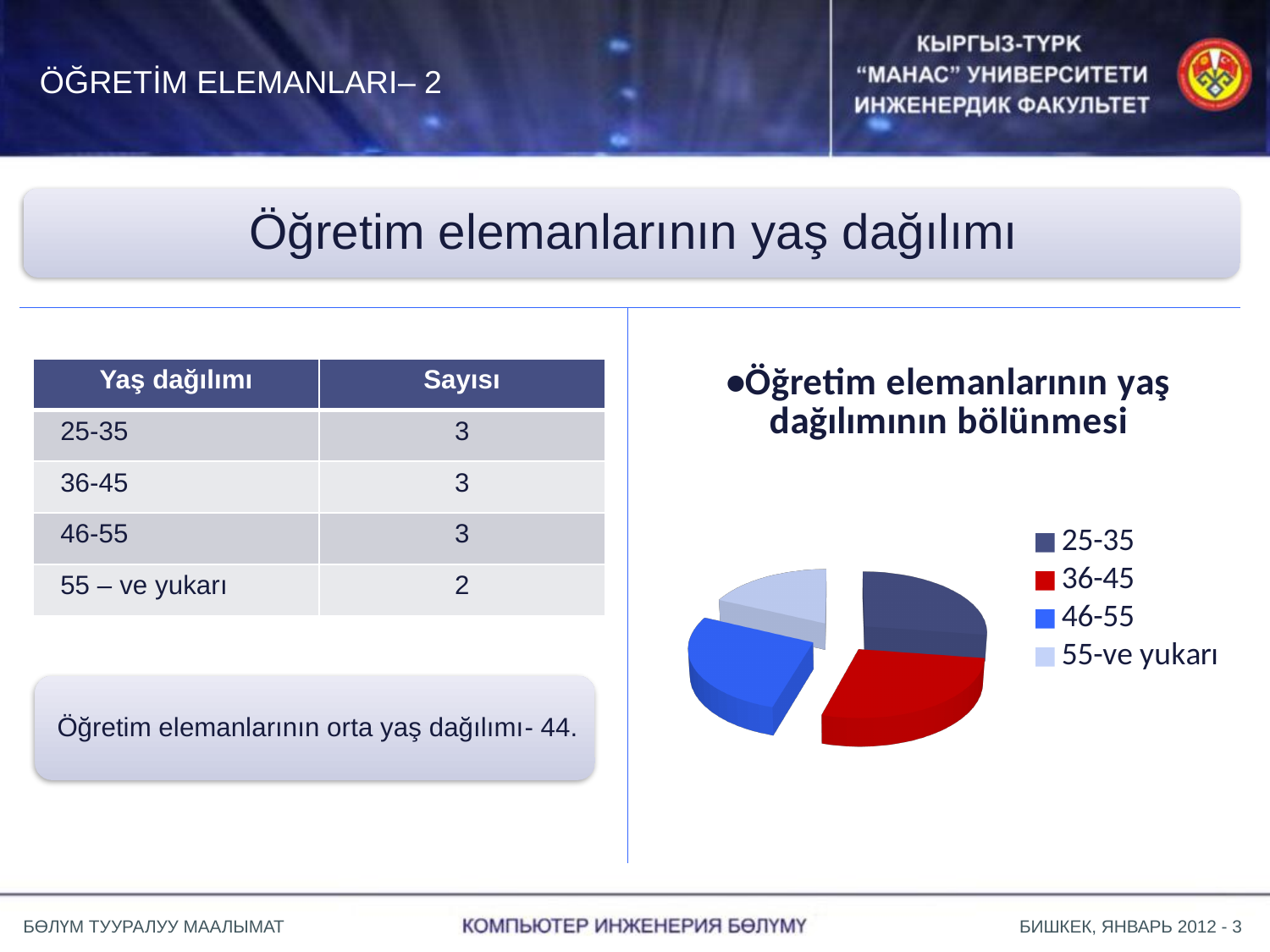
How many entries does the legend of the pie chart list? 4 Which slice is larger in the pie chart, 36-45 or 55-ve yukarı? 36-45 Which colour represents the 36-45 category in the pie chart? red What kind of chart is shown on the slide? pie chart What is the title of the pie chart? Öğretim elemanlarının yaş dağılımının bölünmesi How many slices does the pie chart have? 4 Which slice is larger in the pie chart, 46-55 or 55-ve yukarı? 46-55 Which category has the smallest slice in the pie chart? 55-ve yukarı